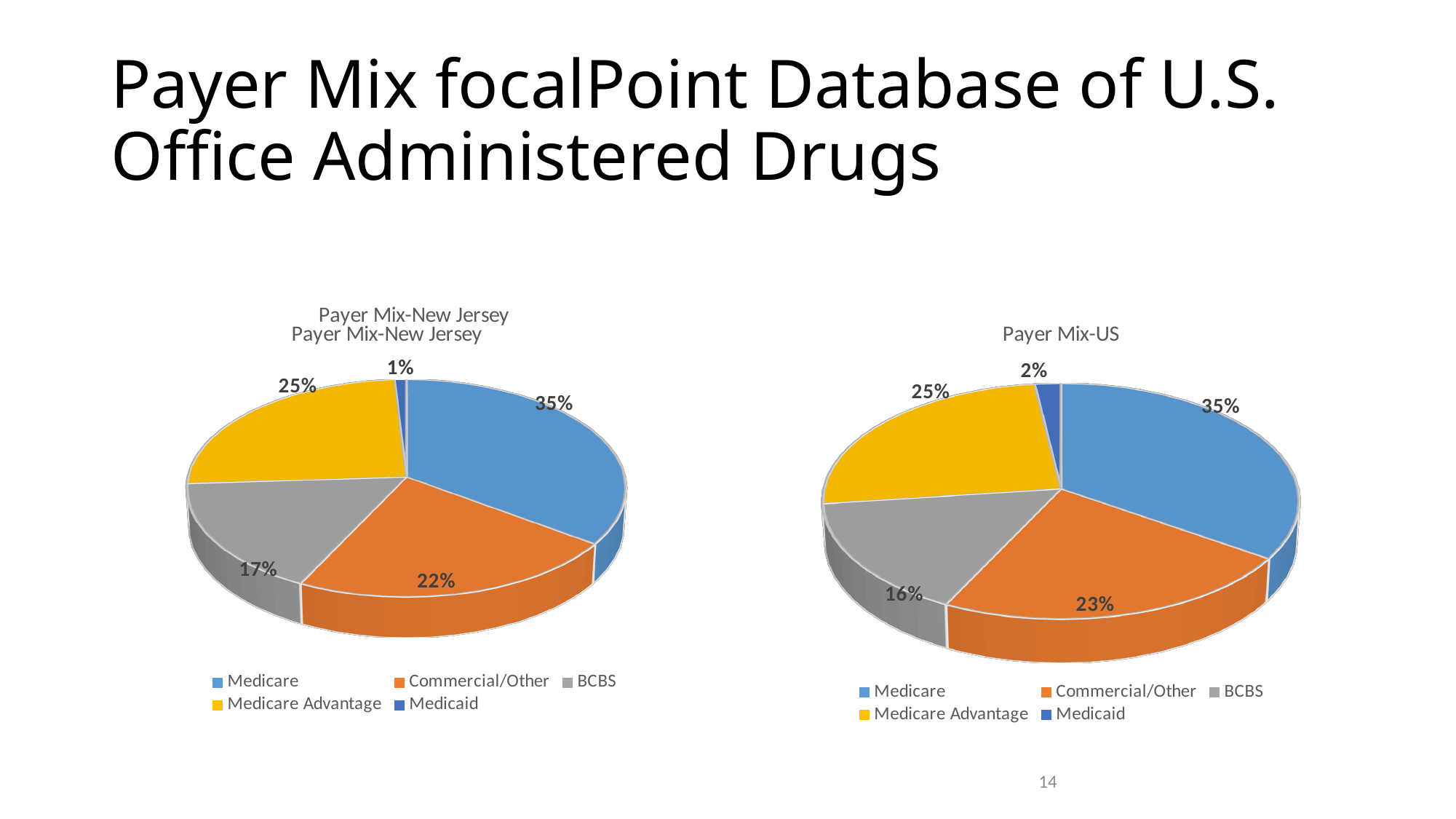
How many slices does the Payer Mix-New Jersey chart have? 5 In the Payer Mix-New Jersey chart, what share does BCBS have? 17% In the Payer Mix-US chart, which is larger, the BCBS share or the Medicare Advantage share? Medicare Advantage In the Payer Mix-US chart, what share does Commercial/Other have? 23% In the Payer Mix-US chart, which colour represents Medicare Advantage? Yellow In the Payer Mix-New Jersey chart, what is the difference between the Medicare Advantage share and the BCBS share? 8% What kind of chart is the Payer Mix-US chart? Pie chart In the Payer Mix-New Jersey chart, which payer has the largest slice? Medicare In the Payer Mix-US chart, what is the difference between the Medicare share and the Commercial/Other share? 12% In the Payer Mix-US chart, what share does Medicaid have? 2% In the Payer Mix-New Jersey chart, what share does Medicare have? 35% In the Payer Mix-US chart, which payer has the smallest slice? Medicaid